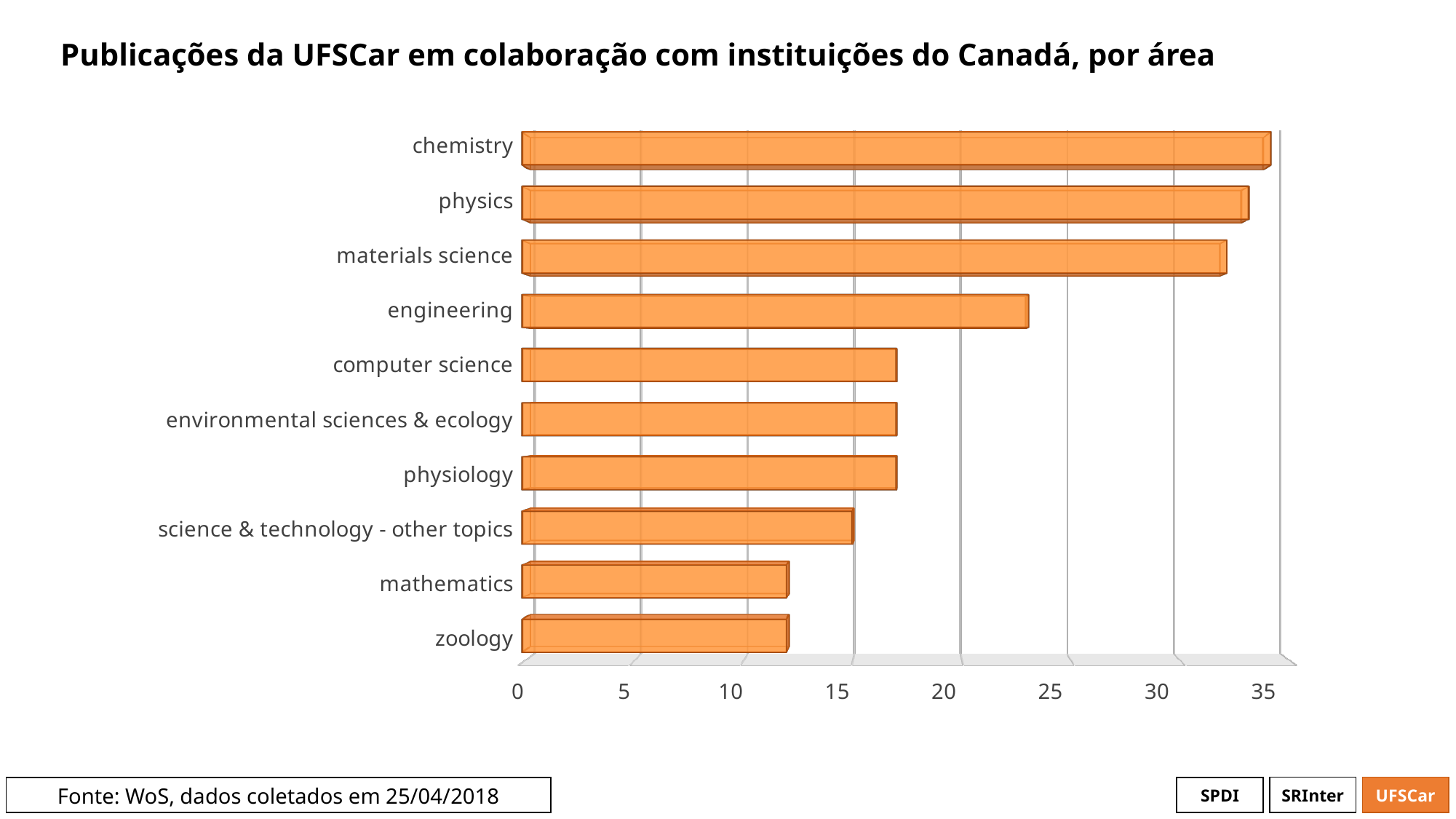
Is the value for mathematics greater or less than 10? greater How many areas (categories) are shown in the chart? 10 Is the value for chemistry greater or less than 30? greater Do the bar values increase or decrease going from the top category to the bottom category? decrease Which has more publications, engineering or computer science? engineering Which has more publications, materials science or physiology? materials science Is the value for zoology greater or less than 15? less Which area has the highest number of publications? chemistry What is the title of the chart? Publicações da UFSCar em colaboração com instituições do Canadá, por área What kind of chart is shown on the slide? bar chart